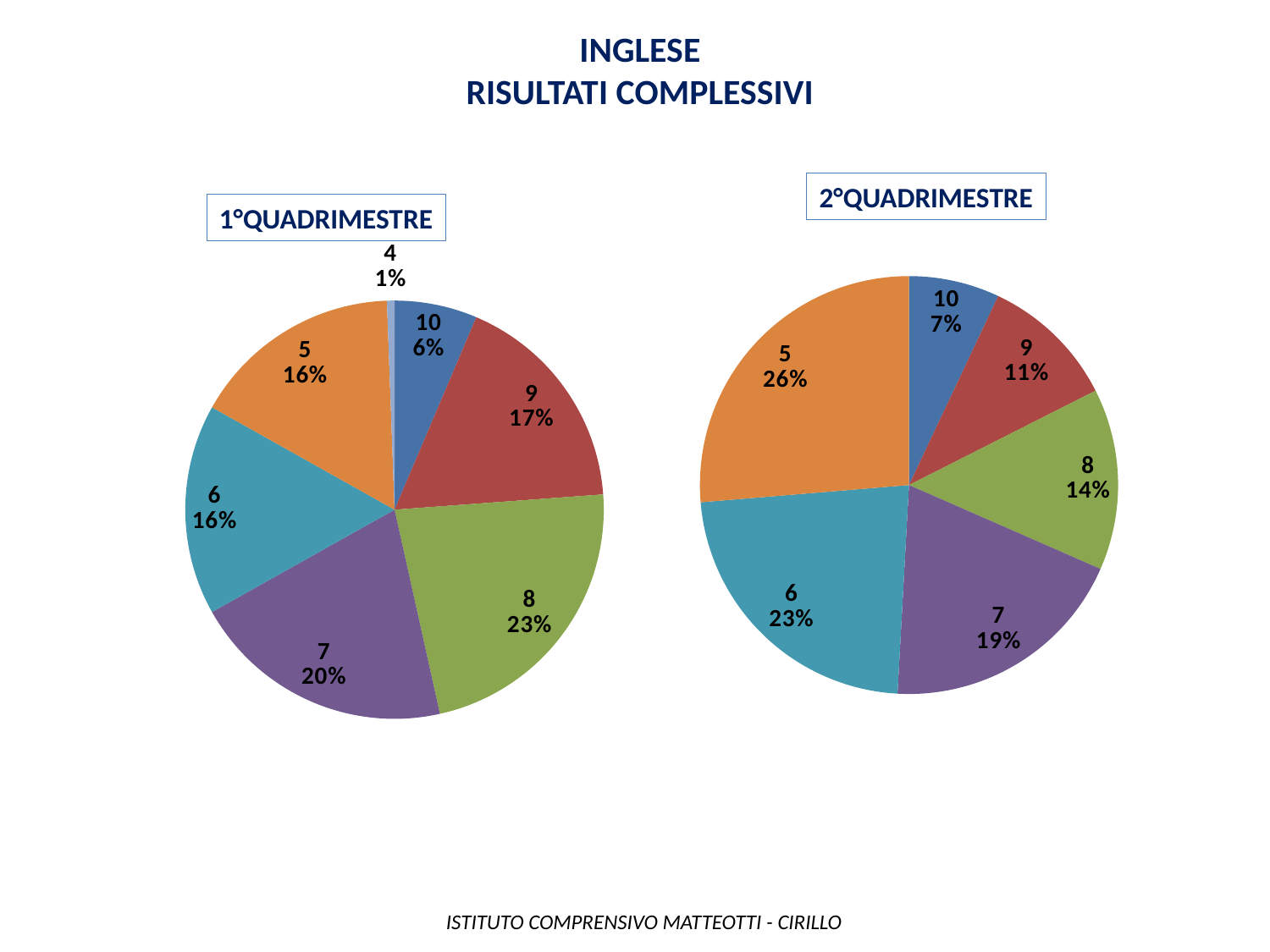
How many slices does the 2°QUADRIMESTRE chart have? 6 In the 1°QUADRIMESTRE chart, which grade has the smallest slice? 4 In the 1°QUADRIMESTRE chart, what share does grade 8 have? 23% In the 1°QUADRIMESTRE chart, which grade has the largest slice? 8 What kind of chart is the 2°QUADRIMESTRE chart? pie chart In the 1°QUADRIMESTRE chart, which is larger, the share of grade 9 or the share of grade 10? 9 How many slices does the 1°QUADRIMESTRE chart have? 7 In the 2°QUADRIMESTRE chart, which grade has the smallest slice? 10 In the 2°QUADRIMESTRE chart, which grade has the largest slice? 5 In the 2°QUADRIMESTRE chart, what is the difference between the shares of grade 5 and grade 8? 12% What is the main title of the slide above the two charts? INGLESE RISULTATI COMPLESSIVI In the 2°QUADRIMESTRE chart, what share does grade 5 have? 26%